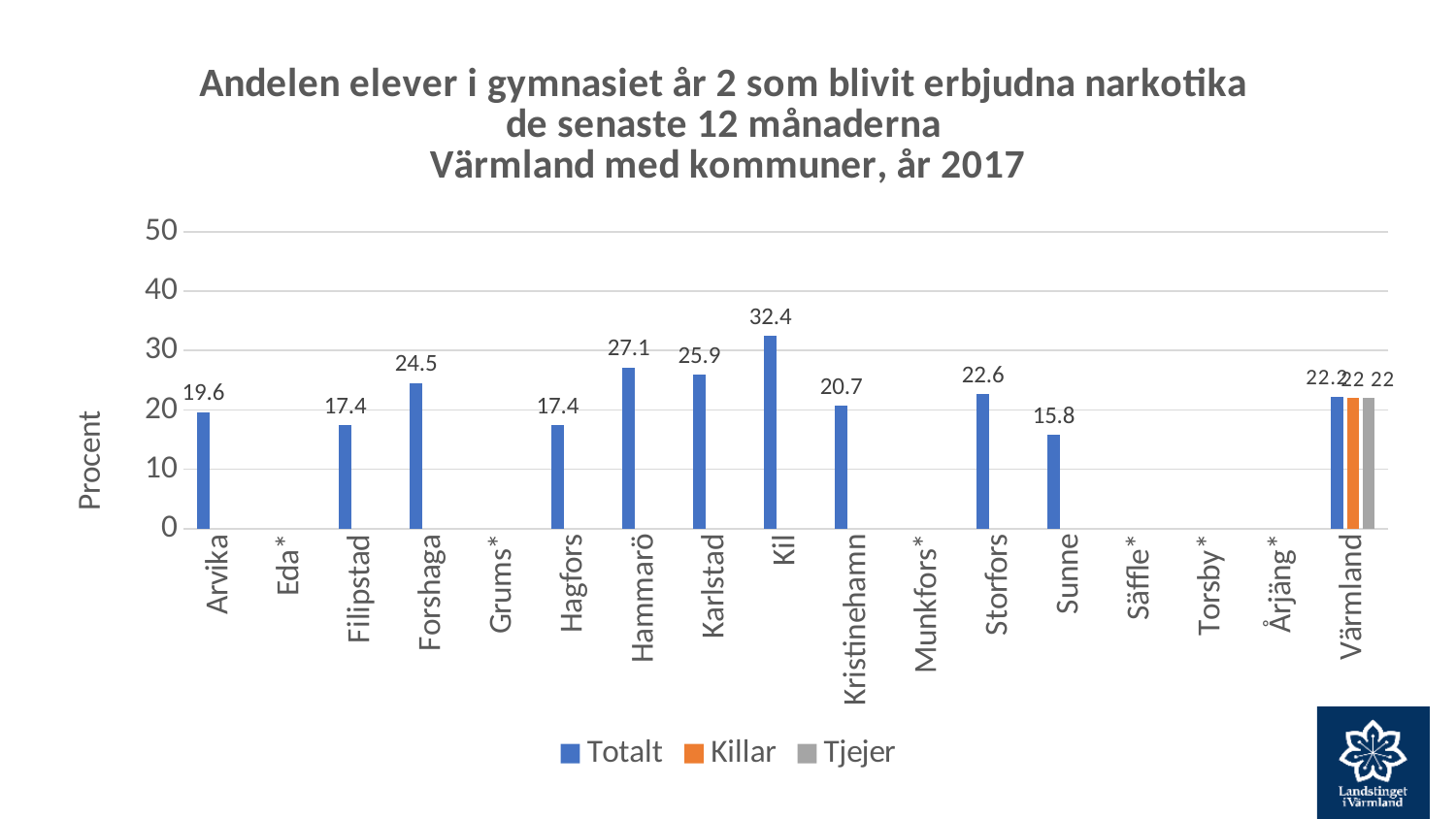
What kind of chart is shown on the slide? bar chart How many series does the legend list? 3 What is the Totalt value for Forshaga? 24.5 Which has a higher Totalt value, Hammarö or Karlstad? Hammarö Is the Totalt value for Kristinehamn greater or less than 30? less What is the label of the y axis? Procent Which municipality has the highest Totalt value? Kil What is the difference between the Totalt values for Kil and Sunne? 16.6 What is the Totalt value for Kil? 32.4 How many categories are shown on the x axis? 17 What is the Killar value for Värmland? 22 Among the municipalities with a plotted bar, which has the lowest Totalt value? Sunne